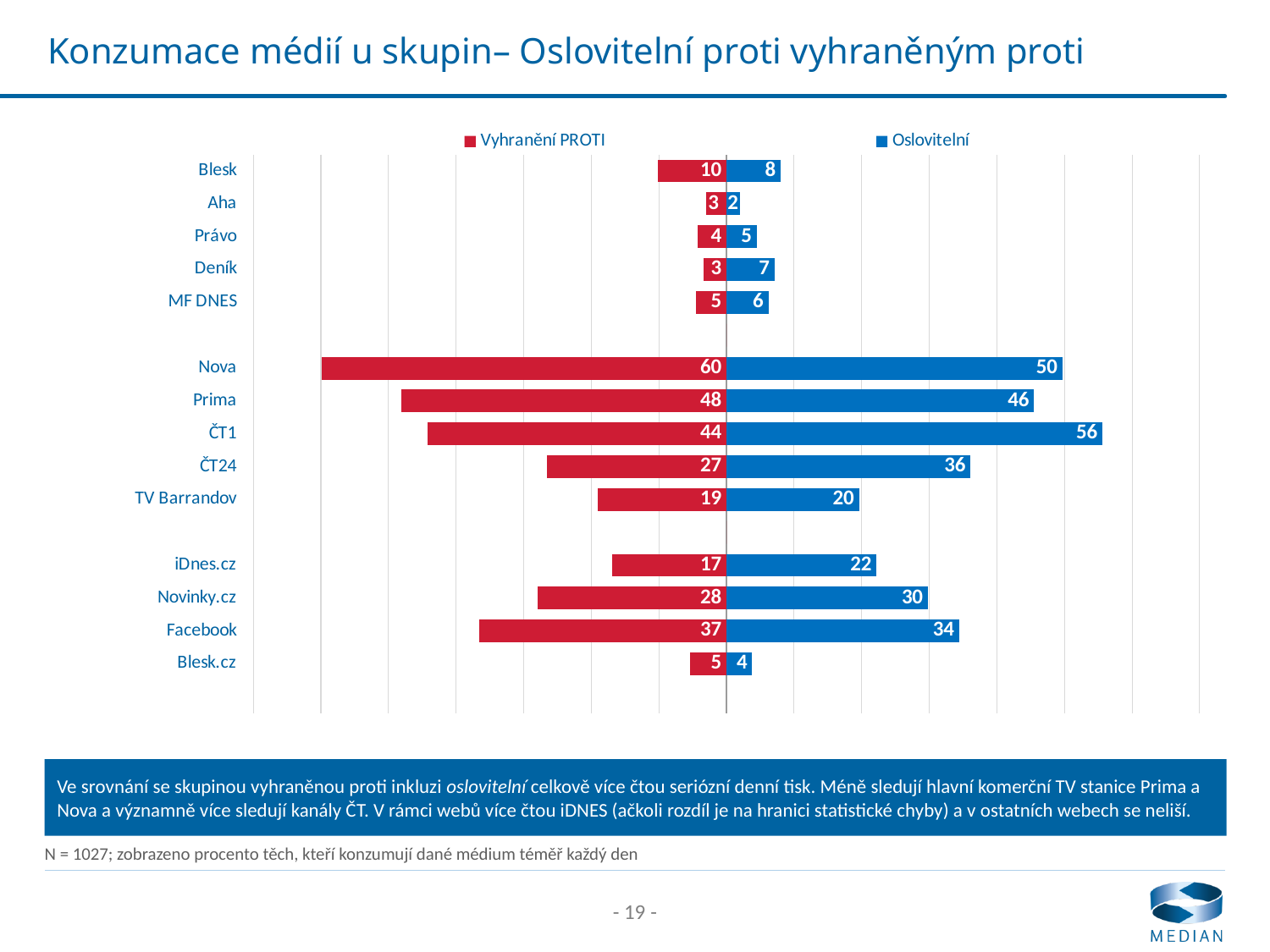
What is the value for Nova in the Vyhranění PROTI series? 60 What is the difference between the Vyhranění PROTI and Oslovitelní values for Nova? 10 What is the difference between the Oslovitelní and Vyhranění PROTI values for ČT1? 12 Which category has the highest value in the Vyhranění PROTI series? Nova How many series does the legend list? 2 Which is larger for ČT24: the Vyhranění PROTI value or the Oslovitelní value? Oslovitelní What kind of chart is shown on the slide? Bar chart Which category has the highest value in the Oslovitelní series? ČT1 What is the value for ČT1 in the Oslovitelní series? 56 What is the value for Facebook in the Oslovitelní series? 34 Which is larger for Prima: the Vyhranění PROTI value or the Oslovitelní value? Vyhranění PROTI How many categories are shown on the chart? 14